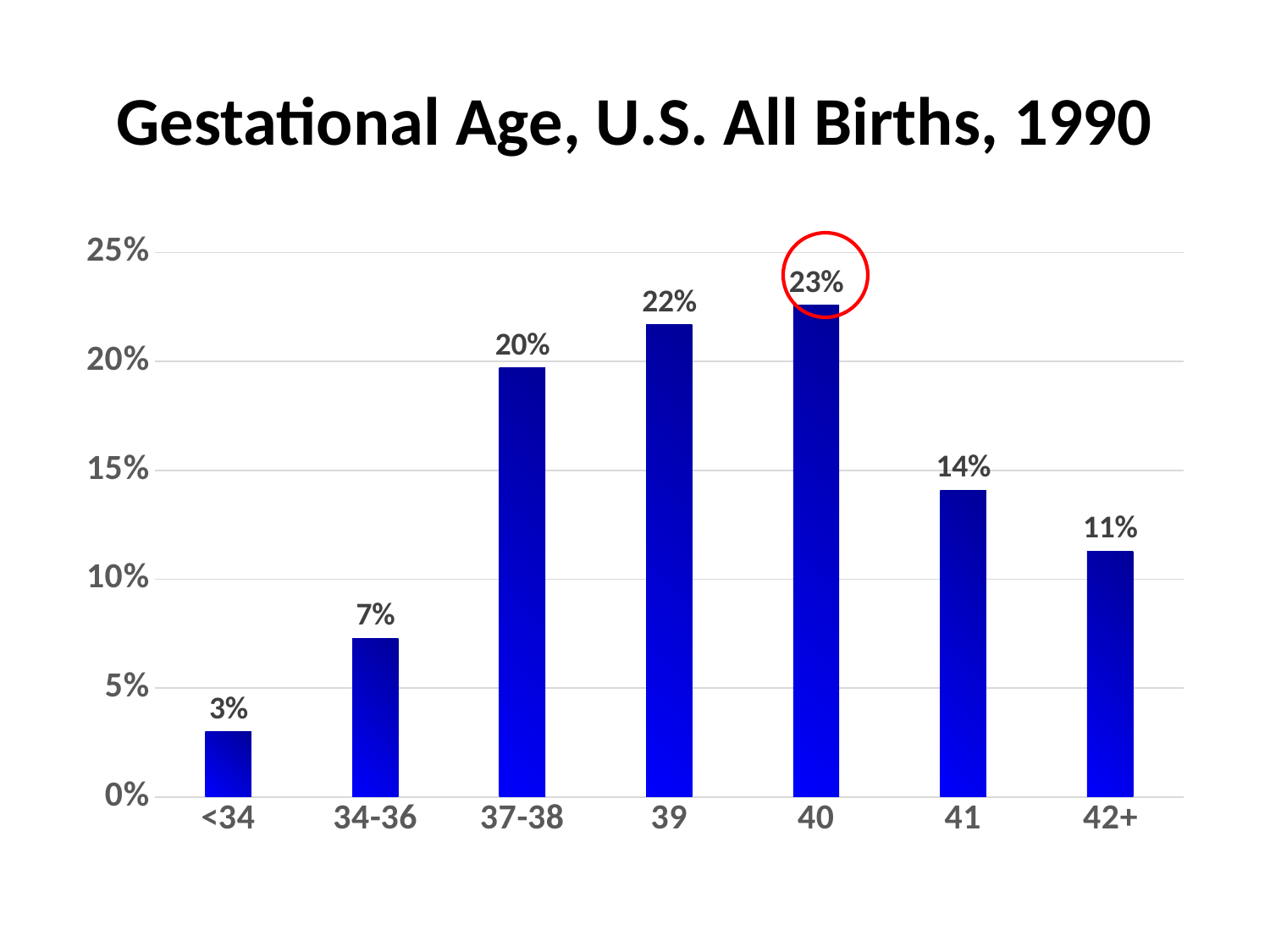
Do the values rise or fall from the 40 category to the 42+ category? fall Which is larger, the value for 37-38 or the value for 42+? 37-38 What percentage of births had a gestational age of 40 weeks? 23% What is the value for the <34 category? 3% What percentage is shown for the 42+ category? 11% Which gestational age category has the highest percentage? 40 Is the value for 34-36 greater or less than 10%? less What kind of chart is shown on the slide? bar chart What is the difference between the values for 39 and 41? 8% How many gestational age categories are shown on the x axis? 7 Which gestational age category has the lowest percentage? <34 What is the title of the chart? Gestational Age, U.S. All Births, 1990